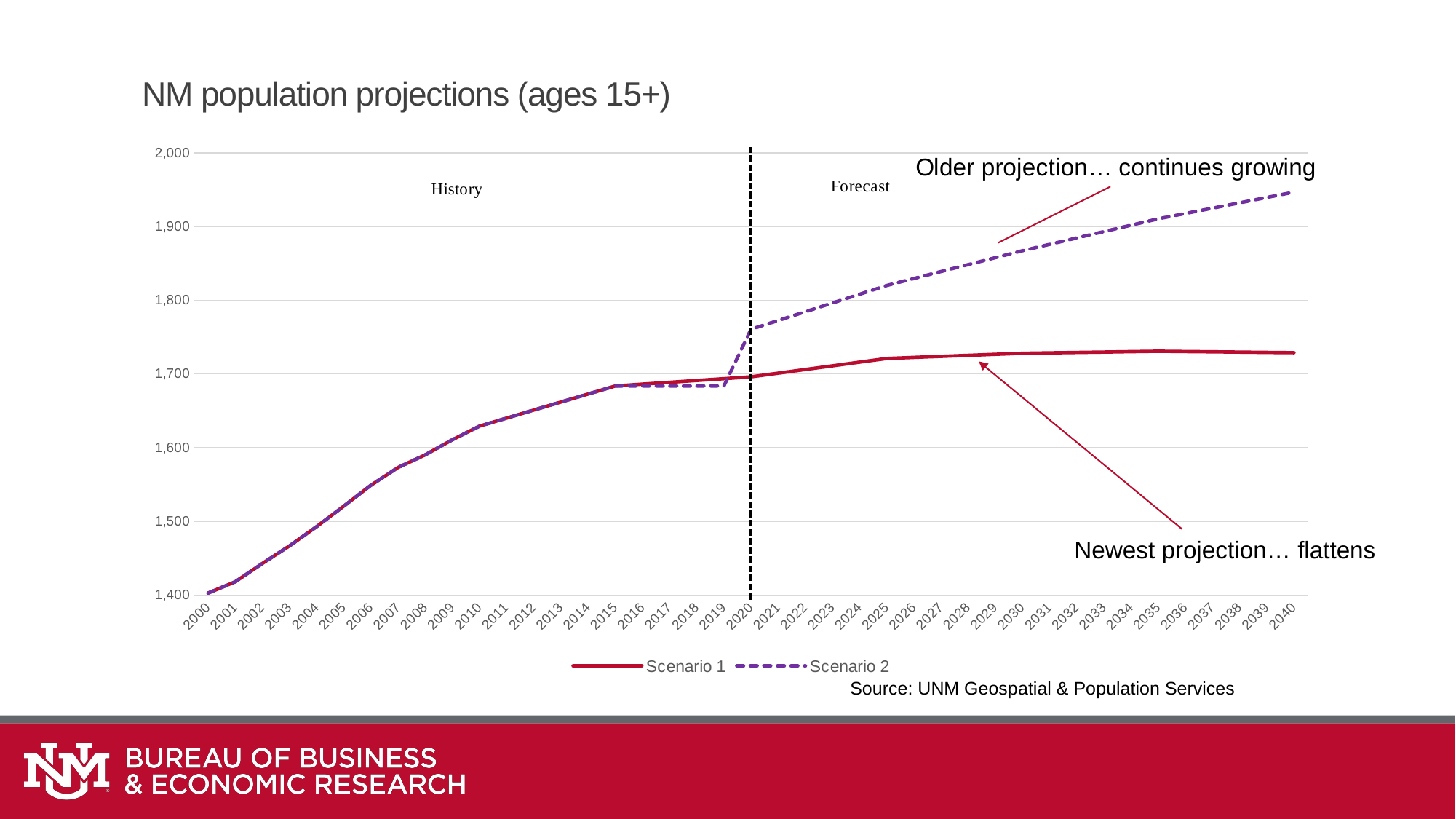
Does Scenario 1 rise or fall between 2000 and 2015? rise How many years are shown on the x axis? 41 How many series does the legend list? 2 What kind of chart is shown on the slide? line chart Is the value for Scenario 1 in 2000 greater or less than 1,500? less At which year does the dashed vertical line separate History from Forecast? 2020 Does Scenario 2 rise or fall between 2020 and 2040? rise Is the value for Scenario 1 in 2030 greater or less than 1,800? less In 2040, which series has the higher value, Scenario 1 or Scenario 2? Scenario 2 Is the value for Scenario 1 in 2040 greater or less than 1,800? less What is the title of the chart? NM population projections (ages 15+)